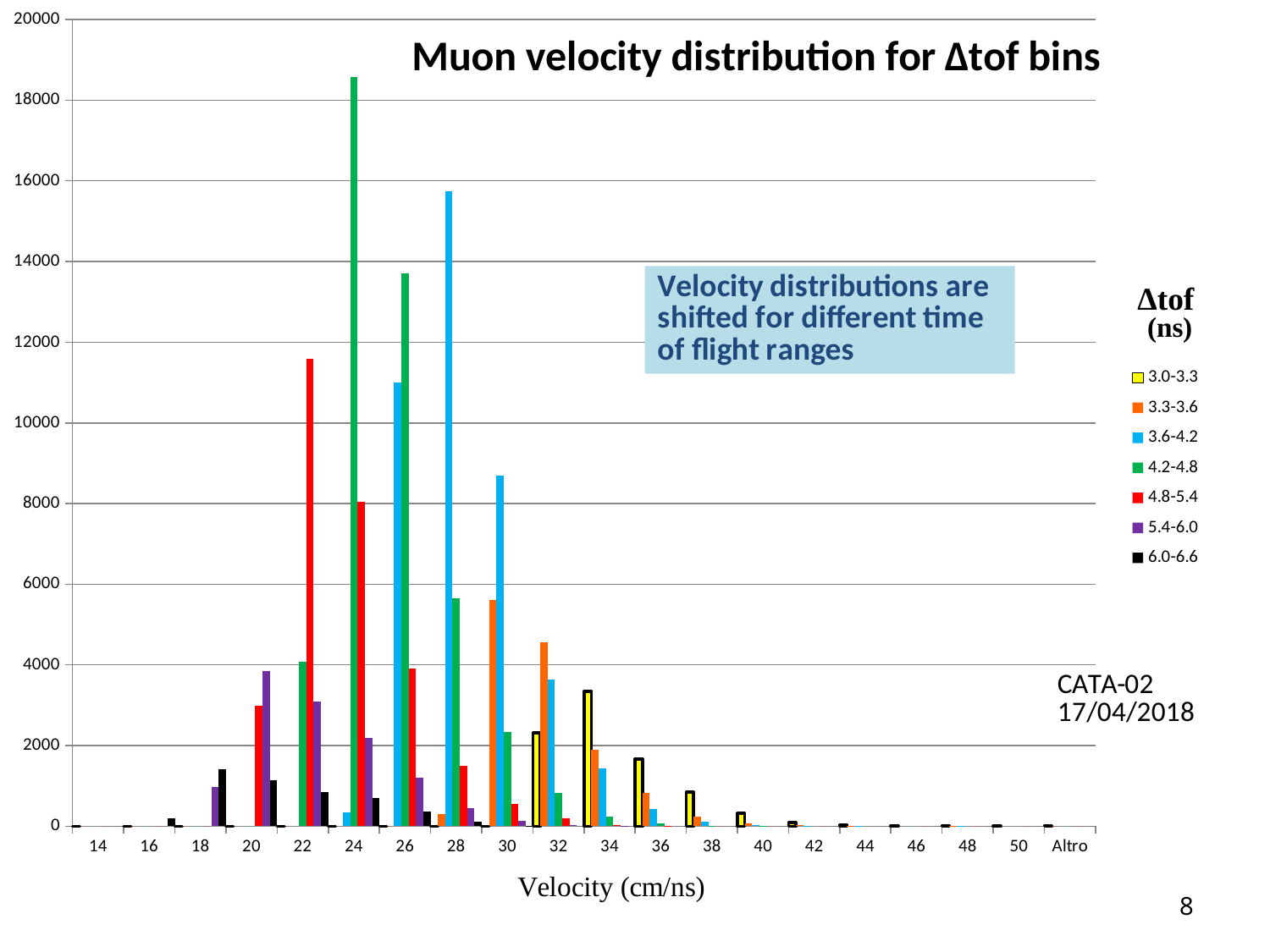
Is the value for the 4.8-5.4 series at velocity 22 greater or less than 10000? greater Which Δtof series has the tallest bar in the chart? 4.2-4.8 How many series does the legend list? 7 Is the value for the 3.6-4.2 series at velocity 28 greater or less than 14000? greater Is the value for the 3.3-3.6 series at velocity 32 greater or less than 4000? greater What is the title of the chart? Muon velocity distribution for Δtof bins What is the label of the x axis? Velocity (cm/ns) What type of chart is shown on the slide? bar chart Which is larger: the 4.2-4.8 bar at velocity 26 or the 3.6-4.2 bar at velocity 28? the 3.6-4.2 bar at velocity 28